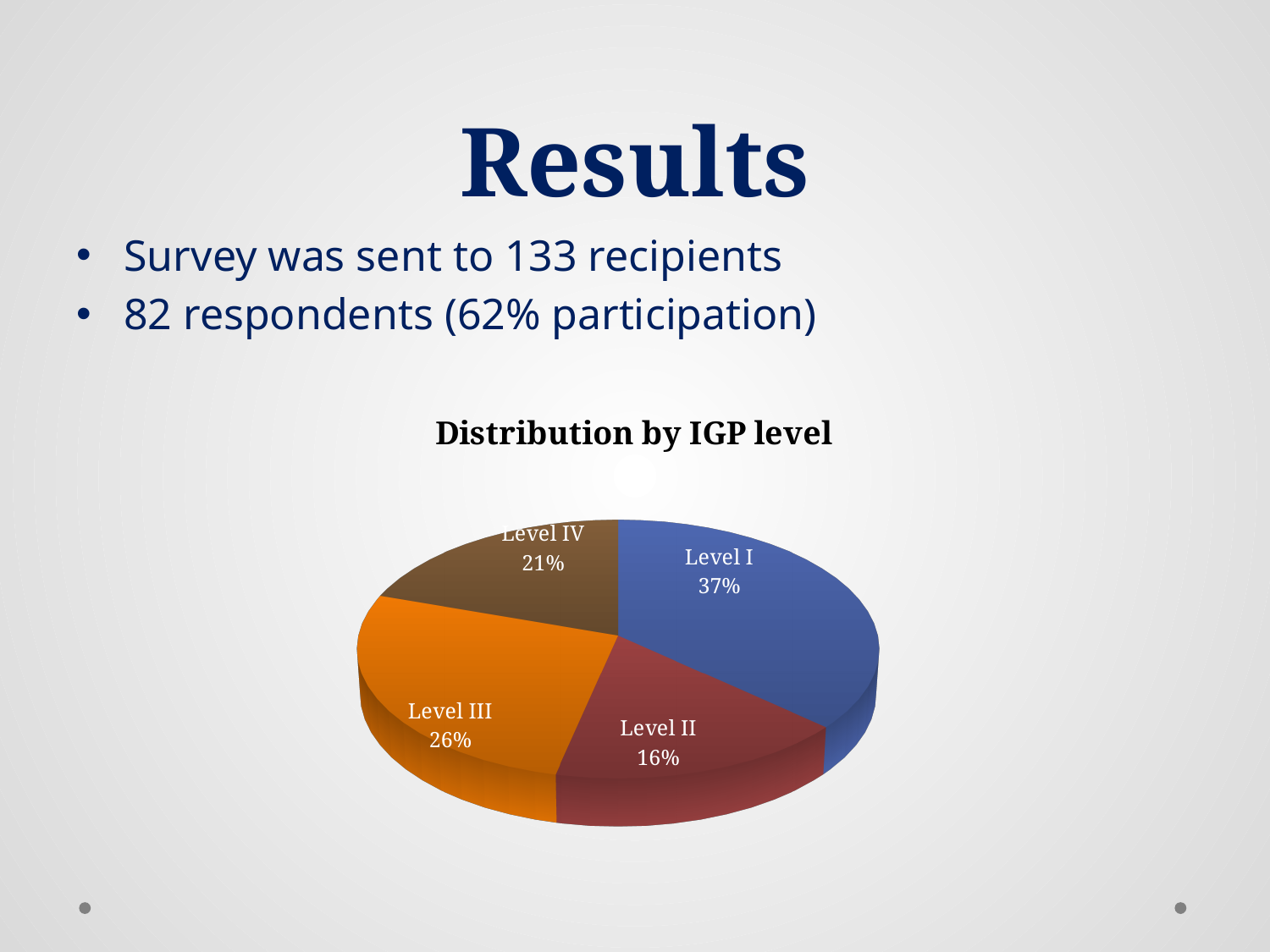
What is the difference in percentage points between Level I and Level II? 21 What share of the pie does Level IV represent? 21% Which is larger, the share for Level III or the share for Level IV? Level III What kind of chart is shown on the slide? pie chart How many slices does the pie chart have? 4 Which level has the largest share of the pie? Level I What share of the pie does Level II represent? 16% What is the title of the chart? Distribution by IGP level What share of the pie does Level I represent? 37% What colour is the Level I slice? blue Which level has the smallest share of the pie? Level II